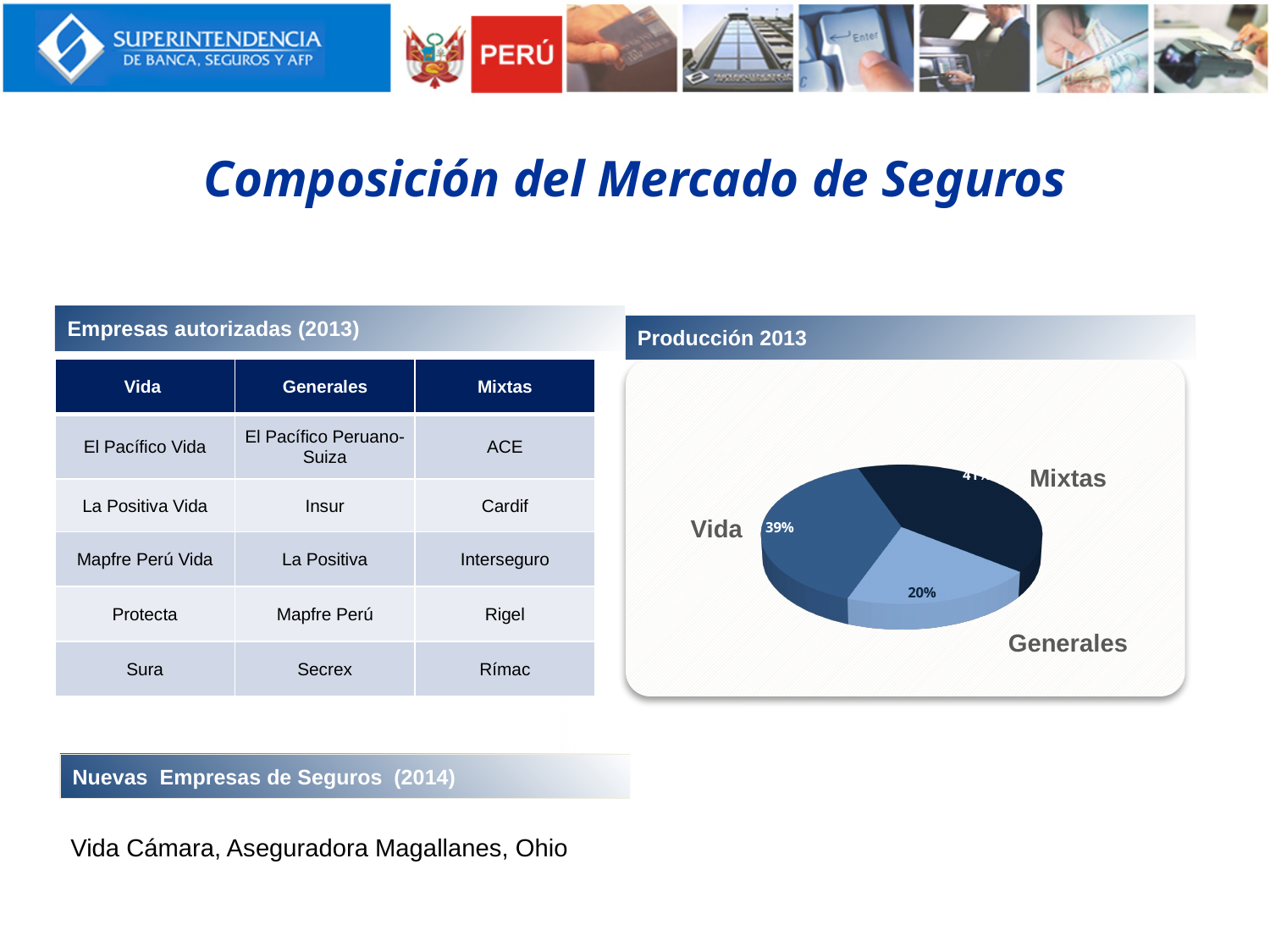
What share of the 'Producción 2013' pie does Generales represent? 20% In the 'Producción 2013' pie chart, which is larger, Mixtas or Generales? Mixtas In the 'Producción 2013' pie chart, what percentage is shown for Generales? 20% Which category has the smallest slice in the 'Producción 2013' pie chart? Generales How many slices does the 'Producción 2013' pie chart have? 3 In the 'Producción 2013' pie chart, what percentage is shown for Vida? 39% What is the title of the pie chart on the slide? Producción 2013 Which category label appears at the bottom right of the 'Producción 2013' pie chart? Generales In the 'Producción 2013' pie chart, which is larger, Vida or Generales? Vida In the 'Producción 2013' pie chart, what is the difference in percentage points between Vida and Generales? 19 What kind of chart is shown under 'Producción 2013'? pie chart